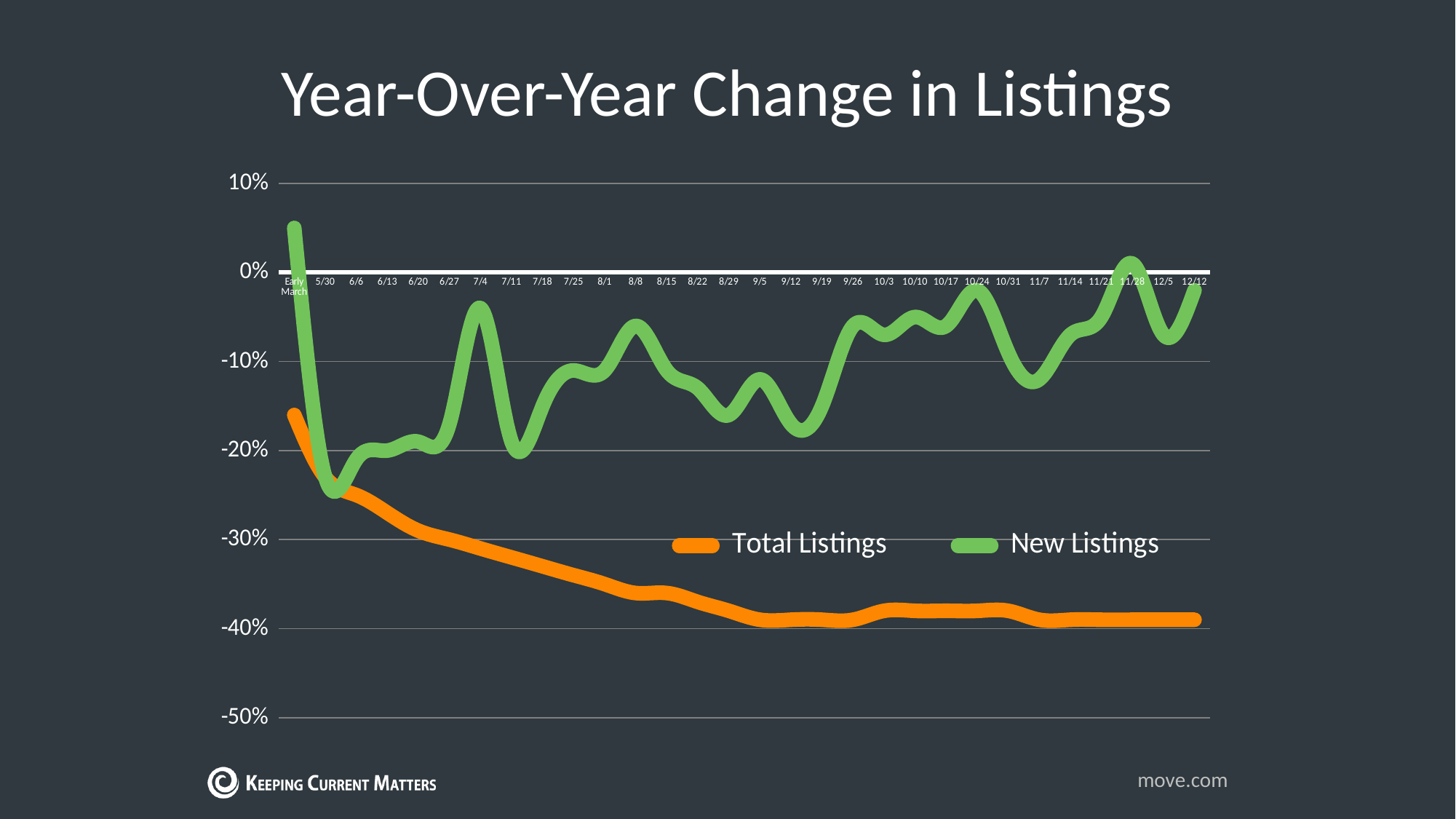
At which date does the New Listings series reach its highest value? Early March Is the value for New Listings at Early March greater or less than 0%? greater Does the Total Listings line rise or fall from Early March to 9/5? fall How many series does the legend list? 2 What kind of chart is shown on the slide? line chart What is the title of the chart? Year-Over-Year Change in Listings Is the value for New Listings at 7/11 greater or less than -10%? less Is the value for New Listings at 7/4 greater or less than -10%? greater How many date labels are shown along the x axis? 30 Which colour represents Total Listings in the chart? orange At 12/12, which series has the higher value, Total Listings or New Listings? New Listings